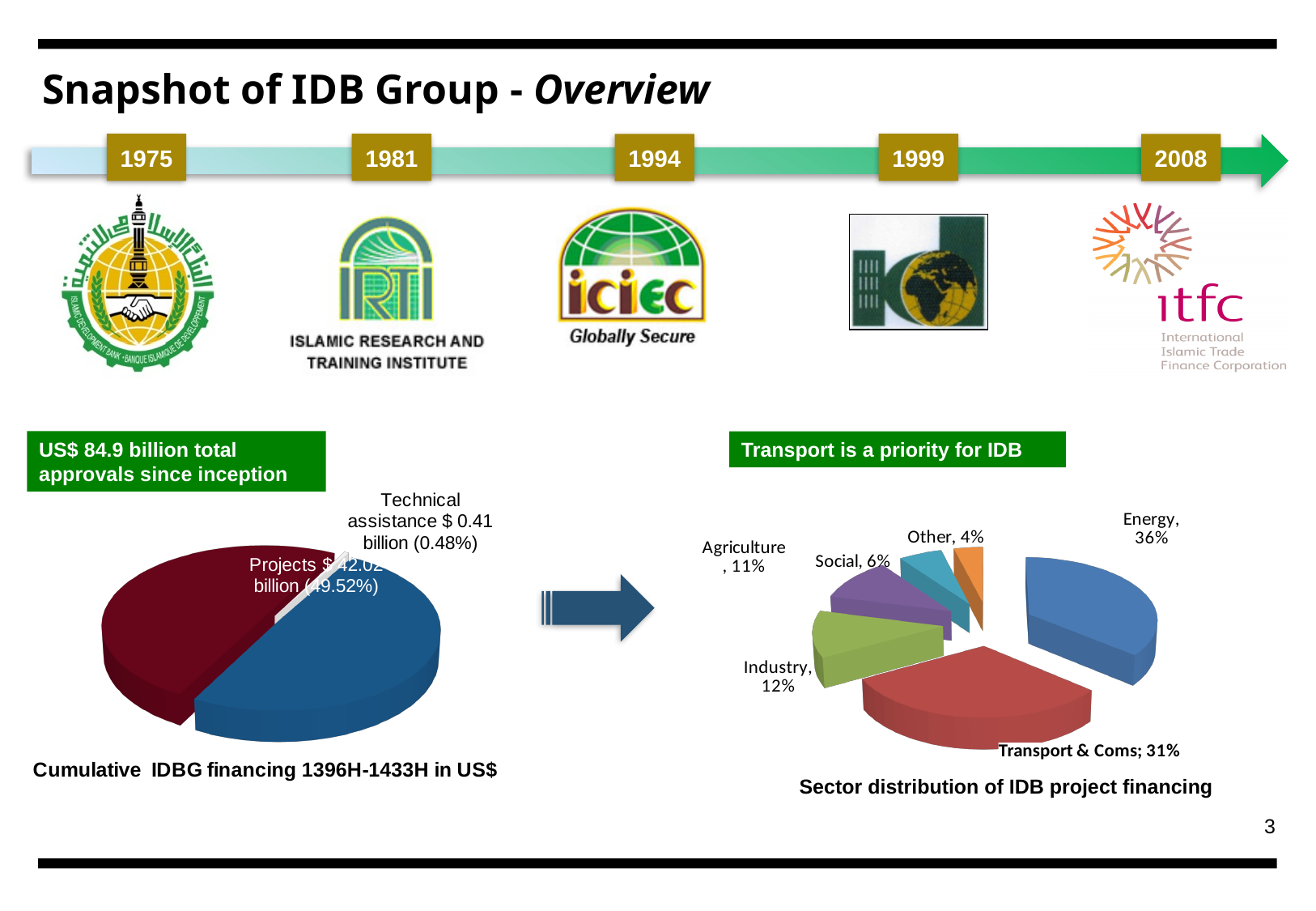
In the 'Sector distribution of IDB project financing' chart, what share does Transport & Coms have? 31% What kind of chart is the 'Cumulative IDBG financing 1396H-1433H in US$' chart? Pie chart In the 'Sector distribution of IDB project financing' chart, which has the larger share, Social or Agriculture? Agriculture In the 'Sector distribution of IDB project financing' chart, which sector has the smallest share? Other In the 'Sector distribution of IDB project financing' chart, what share does Industry have? 12% In the 'Cumulative IDBG financing 1396H-1433H in US$' chart, what share does Technical assistance have? 0.48% In the 'Sector distribution of IDB project financing' chart, how many percentage points larger is Energy's share than Transport & Coms' share? 5 percentage points How many sectors are shown in the 'Sector distribution of IDB project financing' chart? 6 In the 'Cumulative IDBG financing 1396H-1433H in US$' chart, what is the value for Projects? $ 42.02 billion (49.52%) In the 'Sector distribution of IDB project financing' chart, which sector has the largest share? Energy In the 'Sector distribution of IDB project financing' chart, what share does Energy have? 36% What kind of chart is the 'Sector distribution of IDB project financing' chart? Pie chart